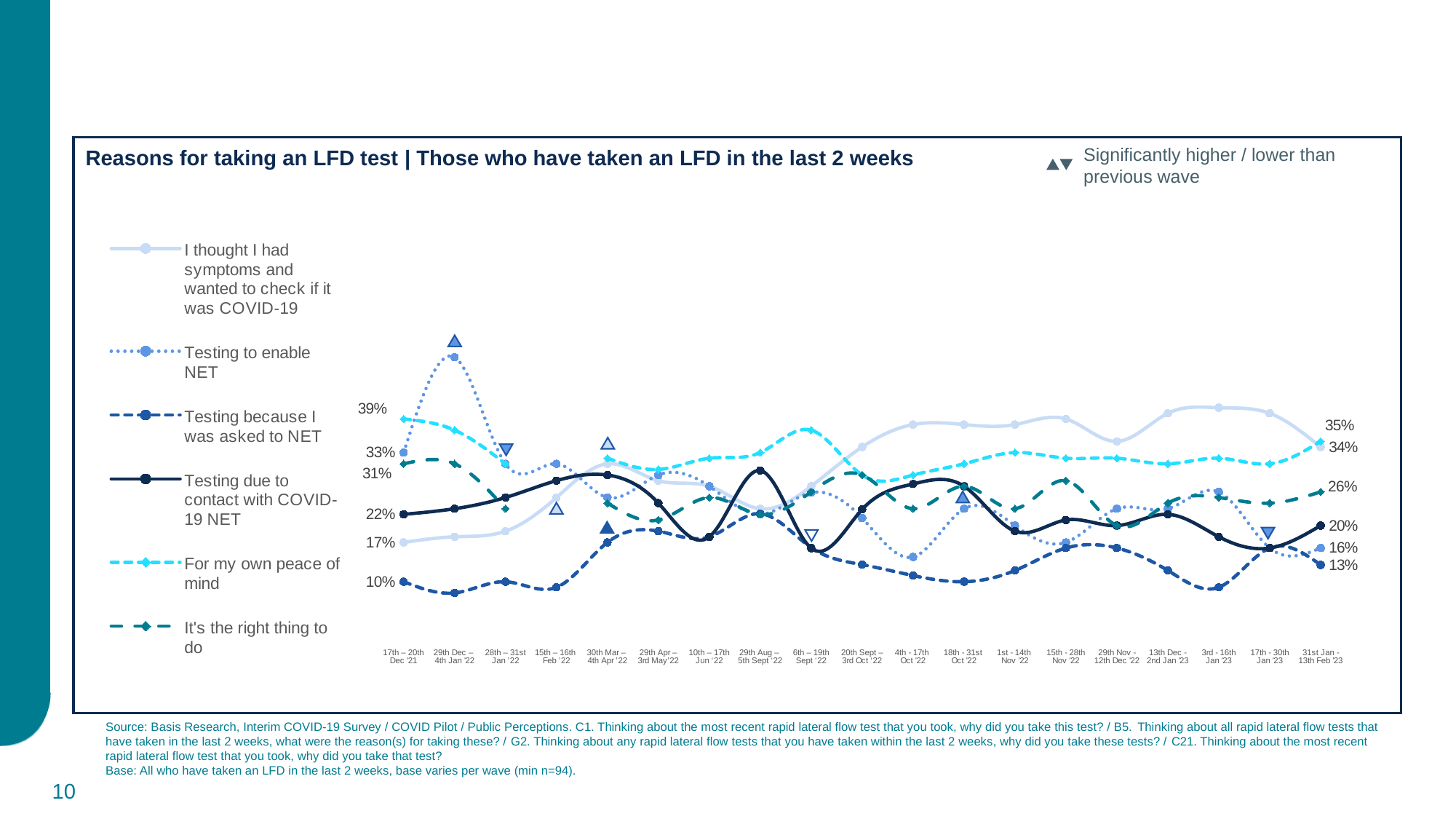
How many survey waves are shown along the x axis? 19 Which reason had the highest value in the first wave (17th – 20th Dec '21)? For my own peace of mind What was the value for 'Testing due to contact with COVID-19 NET' in the last wave (31st Jan - 13th Feb '23)? 20% What kind of chart is shown on the slide? Line chart What was the value for 'Testing due to contact with COVID-19 NET' in the first wave (17th – 20th Dec '21)? 22% Which reason had the lowest value in the first wave (17th – 20th Dec '21)? Testing because I was asked to NET How many series does the legend list? 6 What was the value for 'Testing because I was asked to NET' in the first wave (17th – 20th Dec '21)? 10% By how many percentage points did 'Testing due to contact with COVID-19 NET' change between the first wave (22%) and the last wave (20%)? 2 percentage points lower What was the value for 'For my own peace of mind' in the first wave (17th – 20th Dec '21)? 39% What was the value for 'Testing because I was asked to NET' in the last wave (31st Jan - 13th Feb '23)? 13% What was the value for 'It's the right thing to do' in the last wave (31st Jan - 13th Feb '23)? 26%